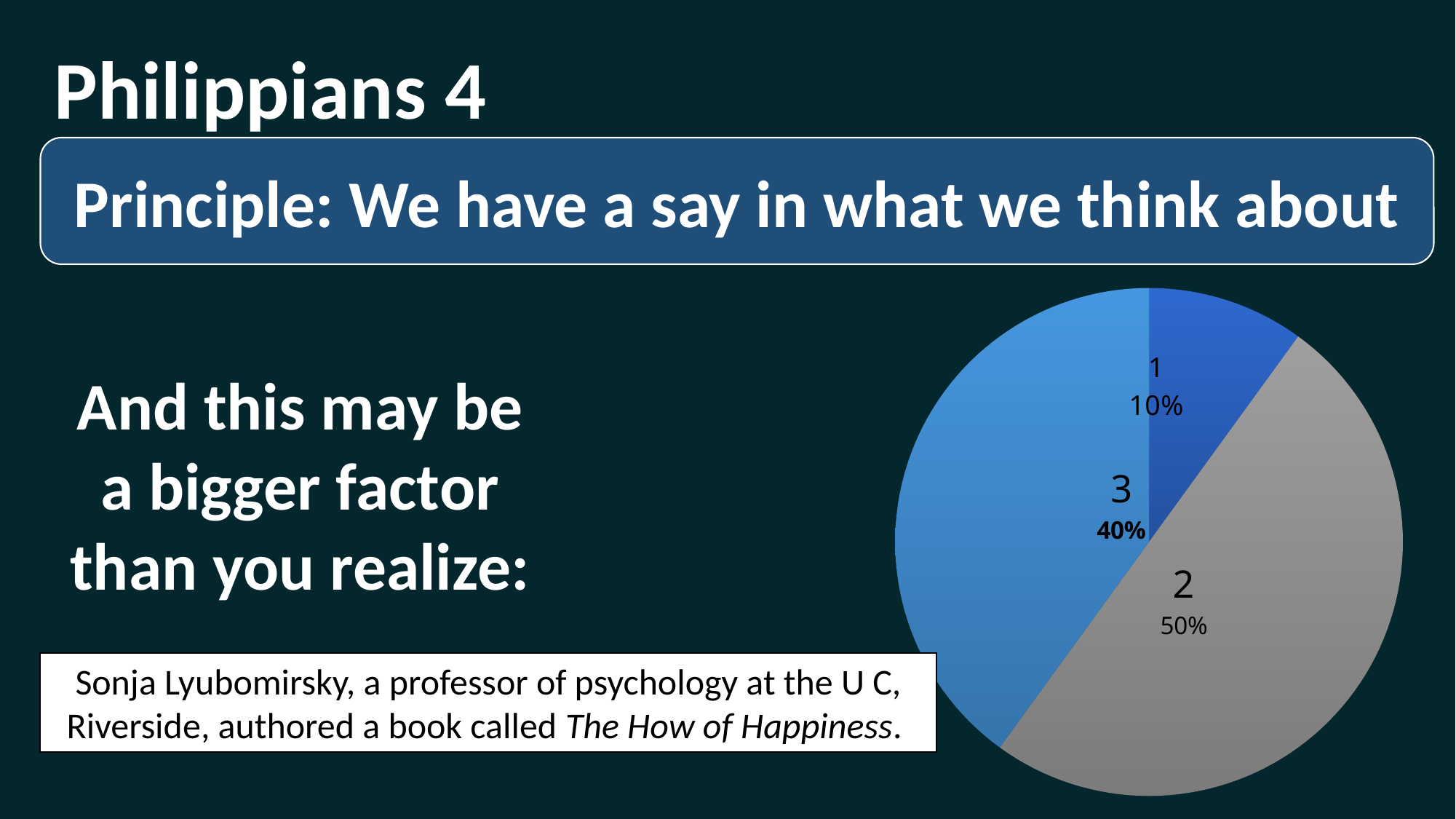
What percentage is shown for slice 2? 50% Which is larger, slice 3 or slice 1? 3 Which slice's label is shown in bold? 3 Which slice is the largest? 2 What kind of chart is shown on the slide? pie chart What percentage is shown for slice 3? 40% What is the difference in percentage points between slice 2 and slice 3? 10 What colour is slice 2 of the pie chart? grey What percentage is shown for slice 1? 10% What is the difference in percentage points between slice 3 and slice 1? 30 How many slices does the pie chart have? 3 Which slice is the smallest? 1